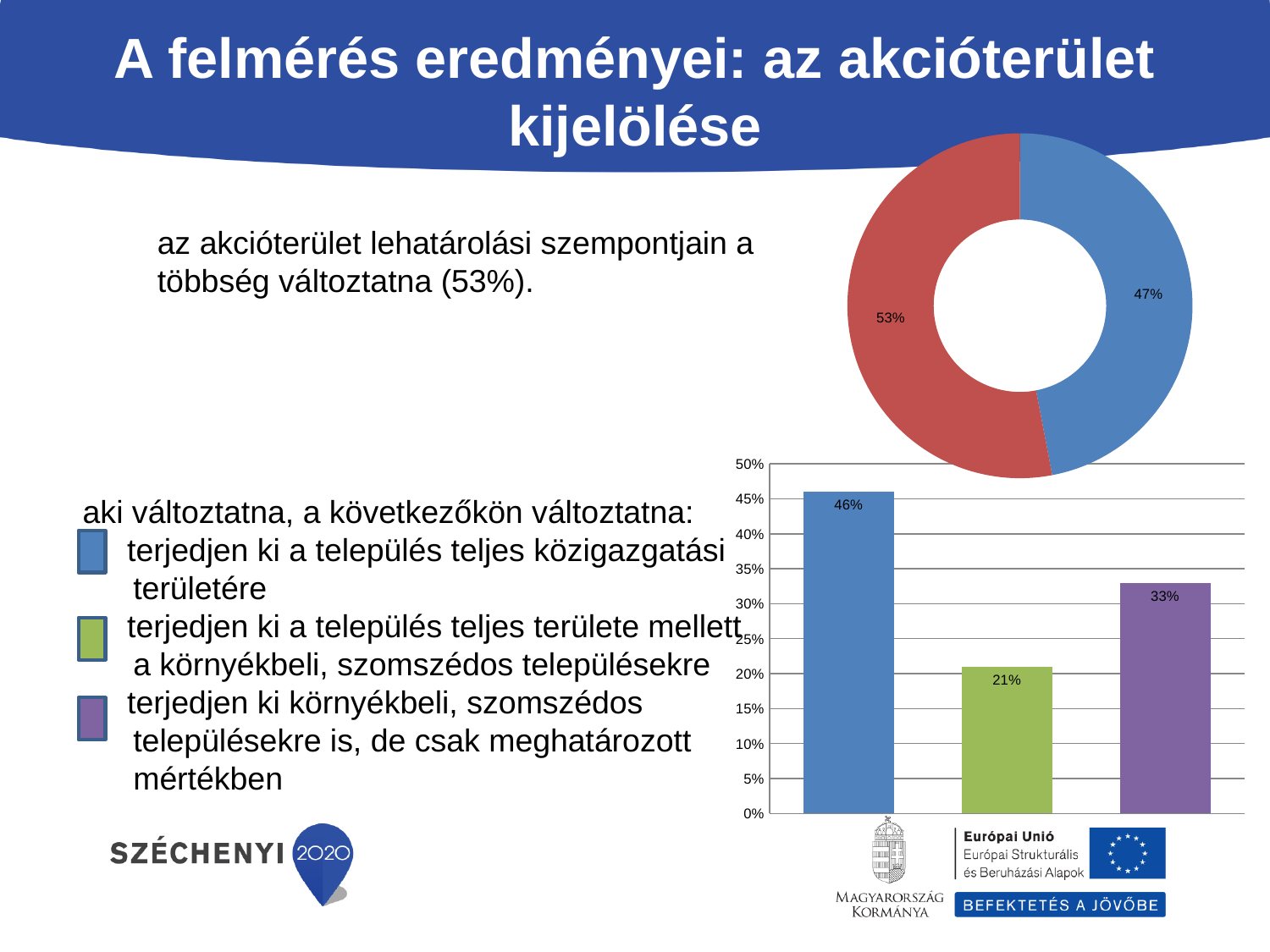
In the bar chart at the bottom right, what is the value of the purple bar (terjedjen ki környékbeli, szomszédos településekre is, de csak meghatározott mértékben)? 33% In the bar chart at the bottom right, how many bars are there? 3 In the doughnut chart at the top right, which slice is larger, the red one or the blue one? the red one In the bar chart at the bottom right, what is the value of the green bar (terjedjen ki a település teljes területe mellett a környékbeli, szomszédos településekre)? 21% In the doughnut chart at the top right, what value is shown for the blue slice? 47% What kind of chart is shown at the bottom right of the slide? bar chart In the doughnut chart at the top right, what value is shown for the red slice? 53% In the bar chart at the bottom right, what is the value of the blue bar (terjedjen ki a település teljes közigazgatási területére)? 46% In the doughnut chart at the top right, what is the difference between the red slice and the blue slice? 6% In the bar chart at the bottom right, what is the difference between the blue bar and the purple bar? 13% In the bar chart at the bottom right, which bar is the lowest? the green bar (21%) In the doughnut chart at the top right, how many slices are there? 2